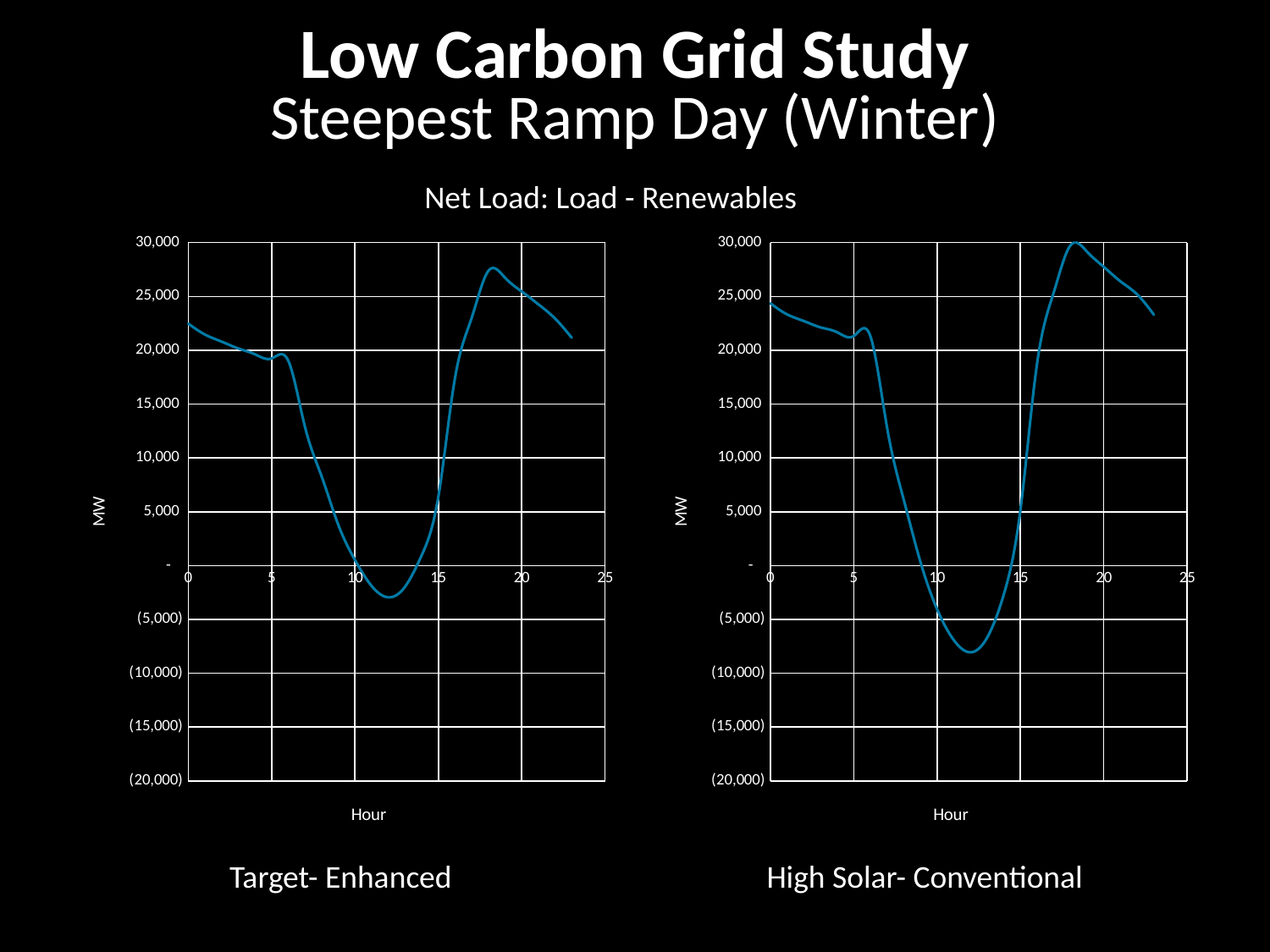
What kind of chart is the Target- Enhanced chart on the left? Line chart In the Target- Enhanced chart, is the peak value around hour 18 greater or less than 25,000? greater In the High Solar- Conventional chart, is the value at hour 20 greater or less than 25,000? greater In the High Solar- Conventional chart, does the net load rise or fall between hour 6 and hour 12? Fall In the High Solar- Conventional chart, is the value at hour 5 greater or less than 20,000? greater What is the y-axis label on both charts? MW What kind of chart is the High Solar- Conventional chart on the right? Line chart What is the title shown above the two charts? Net Load: Load - Renewables Which chart reaches the lower minimum net load, Target- Enhanced or High Solar- Conventional? High Solar- Conventional